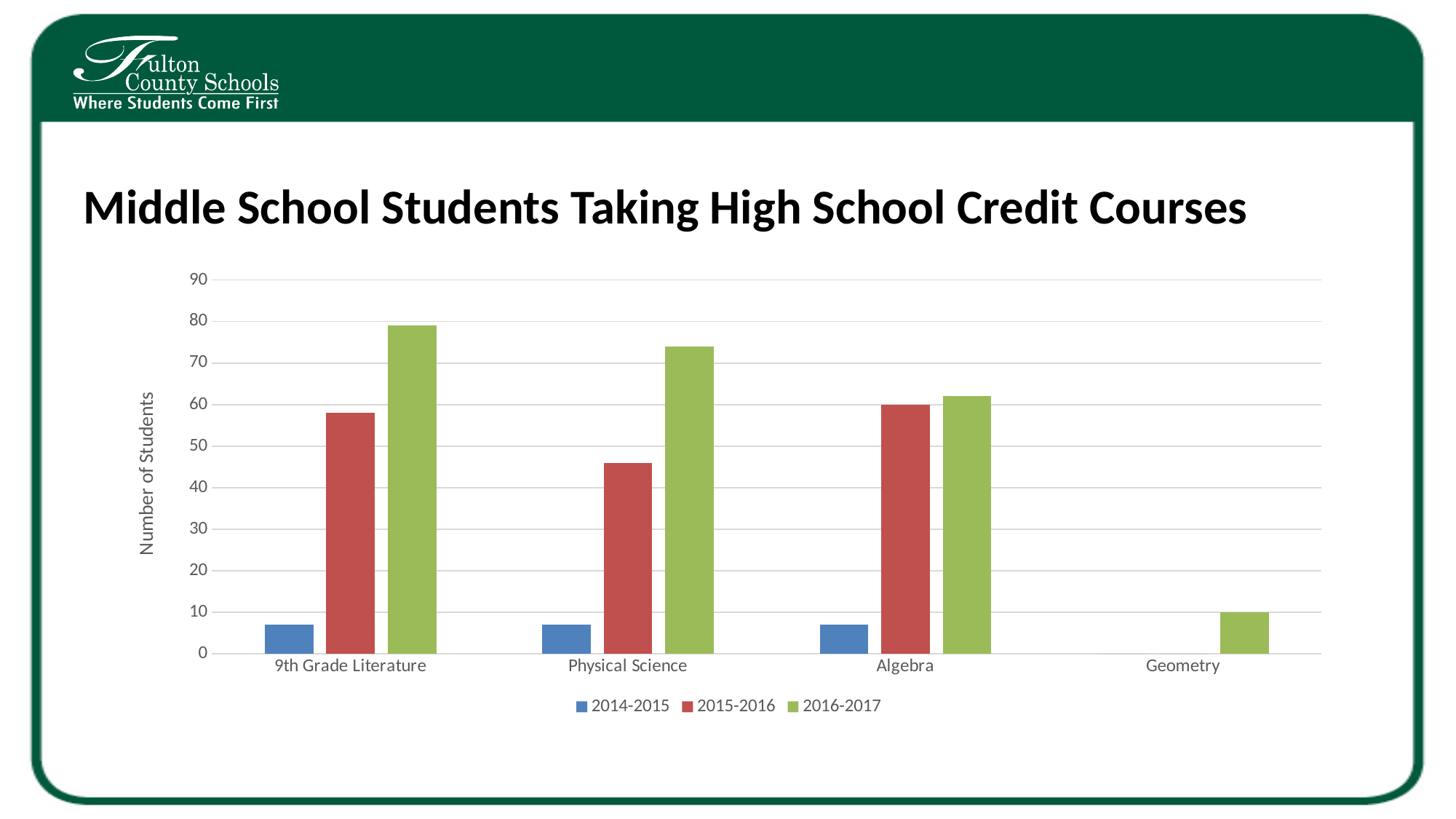
Is the value for 9th Grade Literature in 2016-2017 greater or less than 70? greater Which is larger for 2015-2016: 9th Grade Literature or Physical Science? 9th Grade Literature What kind of chart is shown on the slide? bar chart Is the value for 9th Grade Literature in 2014-2015 greater or less than 10? less Which course has the lowest value for 2016-2017? Geometry How many series does the chart's legend list? 3 Which series is shown in green in the chart's legend? 2016-2017 Is the value for Physical Science in 2015-2016 greater or less than 50? less Which course has the highest value for 2016-2017? 9th Grade Literature How many courses are shown on the x axis of the chart? 4 What is the label on the vertical axis of the chart? Number of Students Do the values for 9th Grade Literature rise or fall from 2014-2015 to 2016-2017? rise